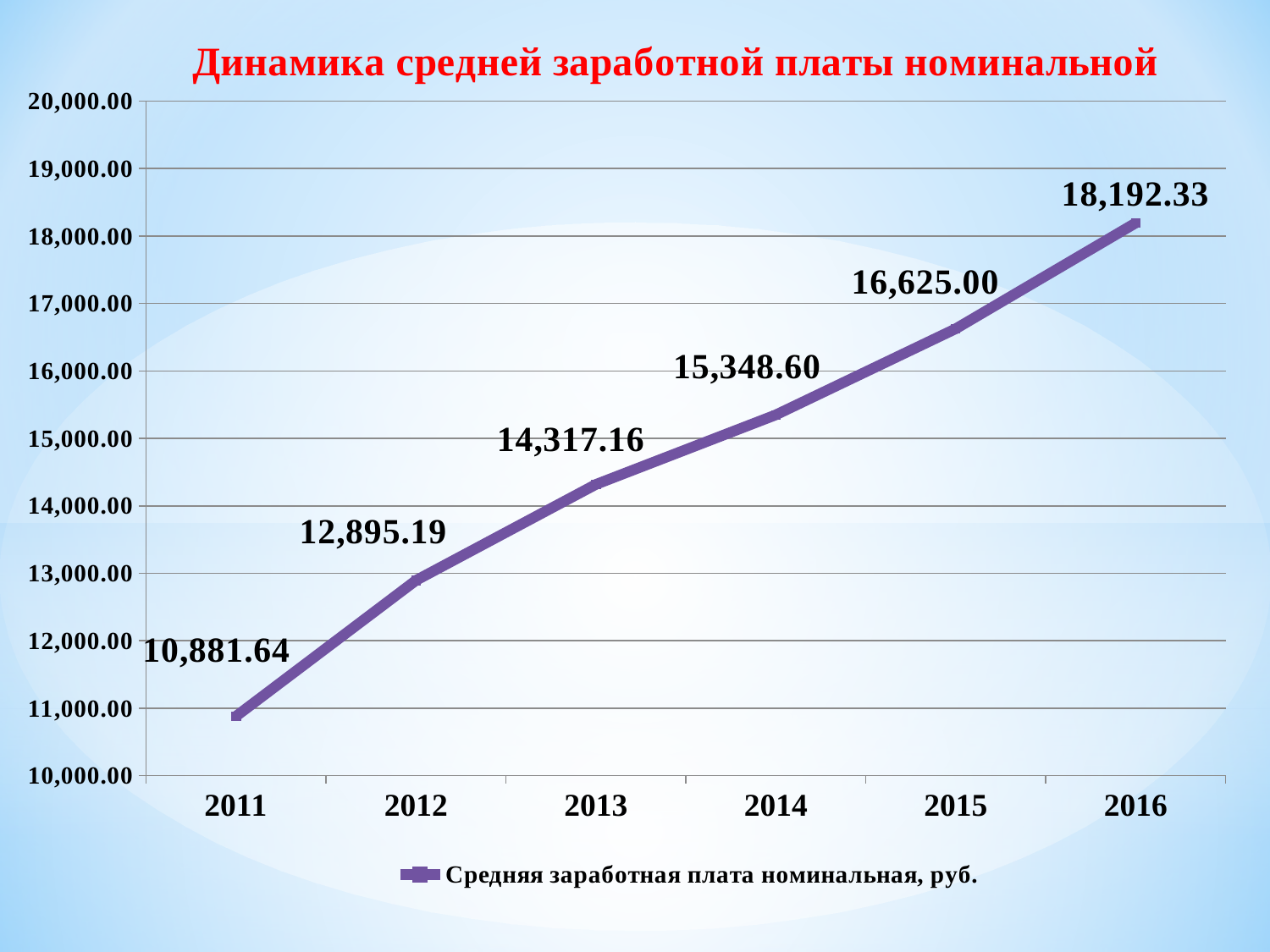
What kind of chart is shown on the slide? line chart By how much did the value increase from 2014 to 2015? 1,276.40 Is the value for 2015 greater or less than 16,000.00? greater What is the value shown for 2016? 18,192.33 Which is larger, the value for 2013 or the value for 2012? 2013 How many years are plotted on the x axis? 6 What value is plotted for 2014? 15,348.60 Which year has the lowest value on the chart? 2011 What is the average nominal wage value shown for 2011? 10,881.64 Which year has the highest value on the chart? 2016 Do the values rise or fall from 2011 to 2016? rise What is the difference between the 2016 value and the 2011 value? 7,310.69